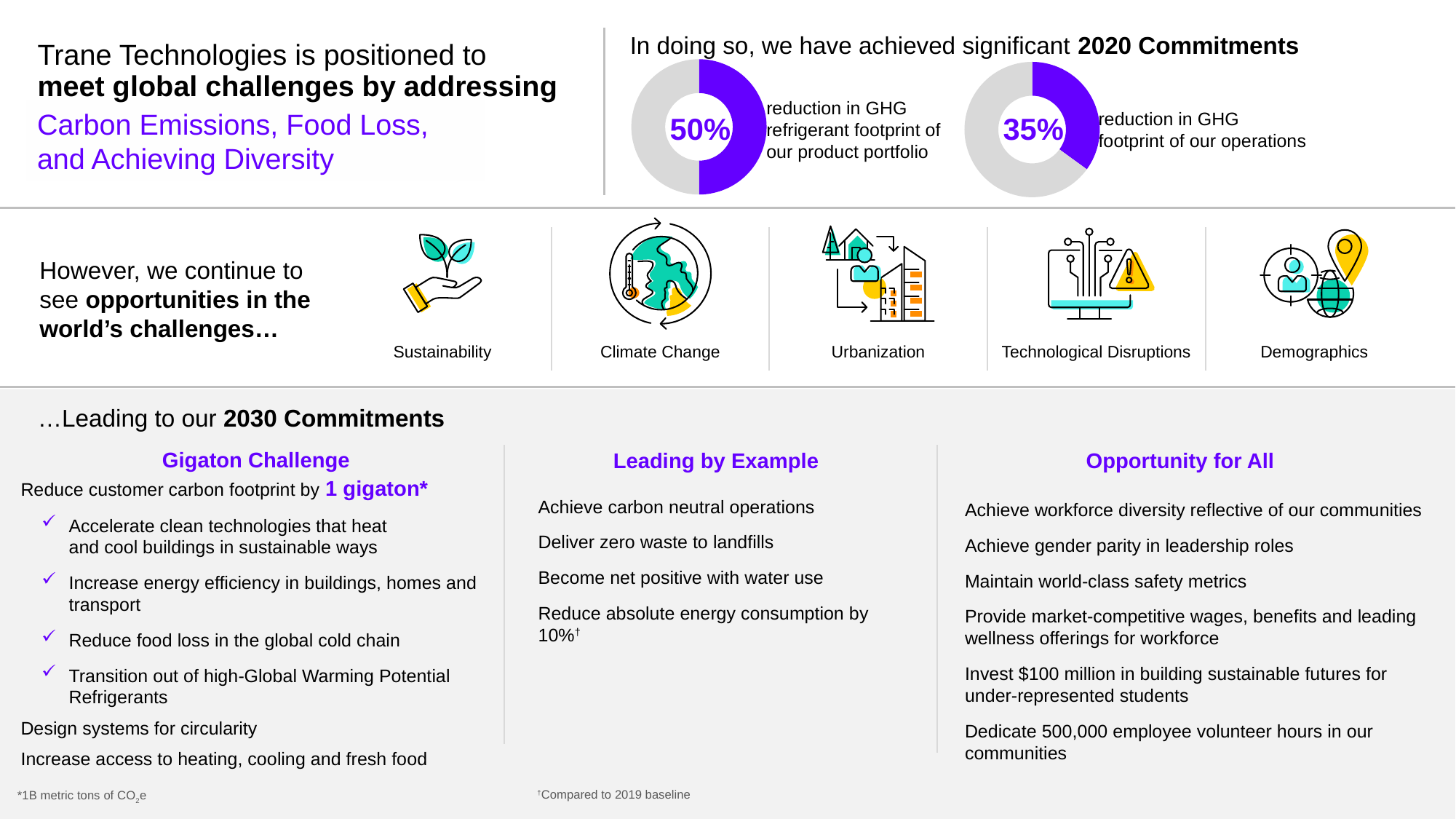
What colour is used for the filled portion of both donut charts? Purple In the left donut chart, what percentage reduction in GHG refrigerant footprint of the product portfolio is shown? 50% In the right donut chart, what percentage reduction in GHG footprint of operations is shown? 35% How many donut charts are shown in the 2020 Commitments section? 2 Which of the two 2020 Commitments donut charts shows the larger percentage, the refrigerant footprint of the product portfolio or the footprint of operations? Refrigerant footprint of the product portfolio What is the heading above the two donut charts? In doing so, we have achieved significant 2020 Commitments What is the difference in percentage points between the left donut chart (50%) and the right donut chart (35%)? 15 percentage points What share of the left donut chart is filled in purple? 50% What kind of chart is used to show the 2020 Commitments figures at the top of the slide? Donut chart Which 2020 Commitment donut chart shows the smallest percentage? Reduction in GHG footprint of our operations (35%)